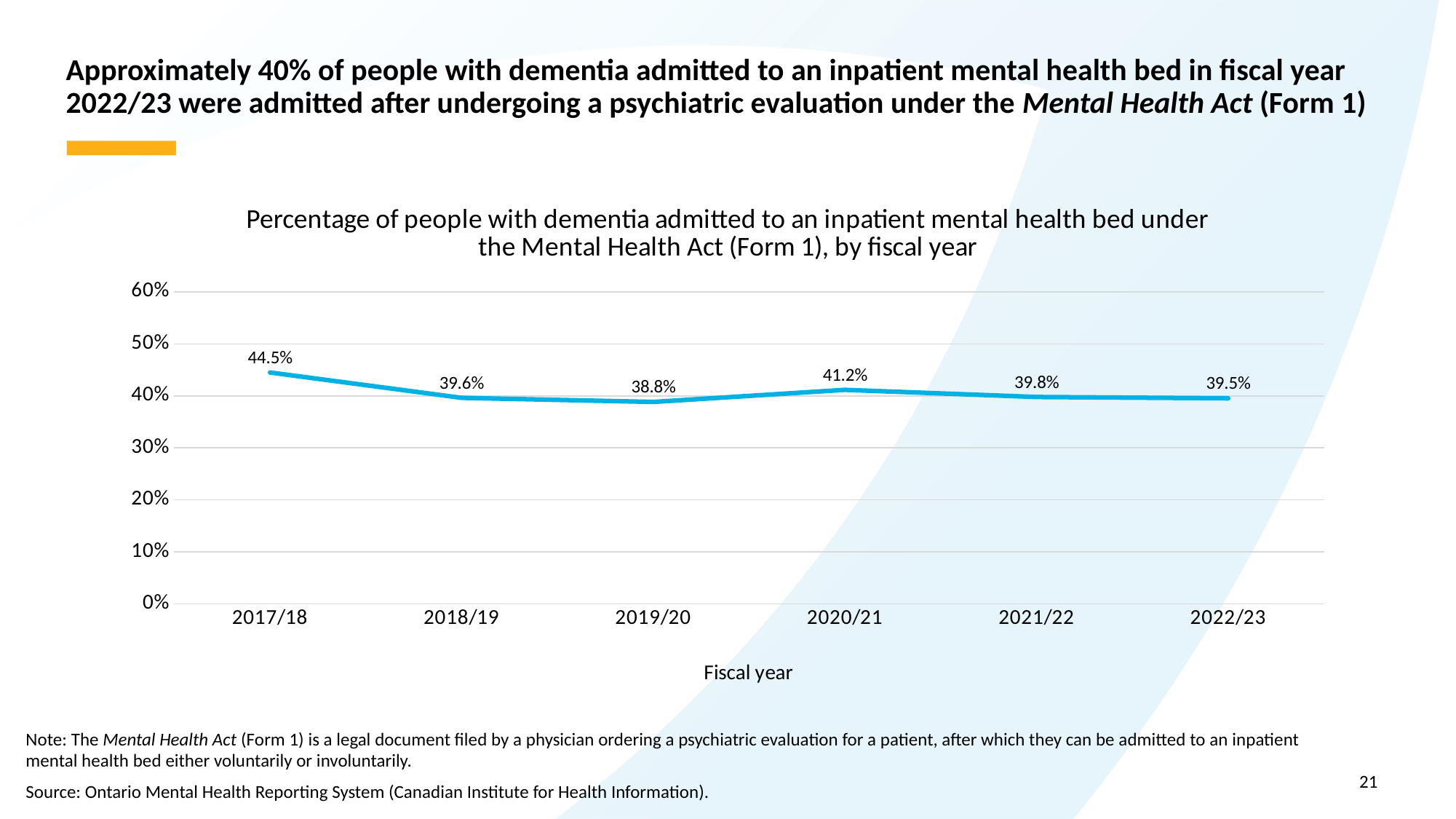
What is the label of the x axis? Fiscal year Does the percentage rise or fall from 2017/18 to 2018/19? Fall What is the difference in percentage points between 2017/18 and 2022/23? 5.0 percentage points Which fiscal year has the lowest percentage? 2019/20 Which is larger, the percentage for 2020/21 or for 2021/22? 2020/21 Which fiscal year has the highest percentage? 2017/18 What kind of chart is shown on the slide? Line chart What is the percentage for fiscal year 2022/23? 39.5% What is the percentage for fiscal year 2017/18? 44.5% How many fiscal years are plotted on the chart? 6 Is the value for 2019/20 greater or less than 40%? less What is the percentage for fiscal year 2020/21? 41.2%